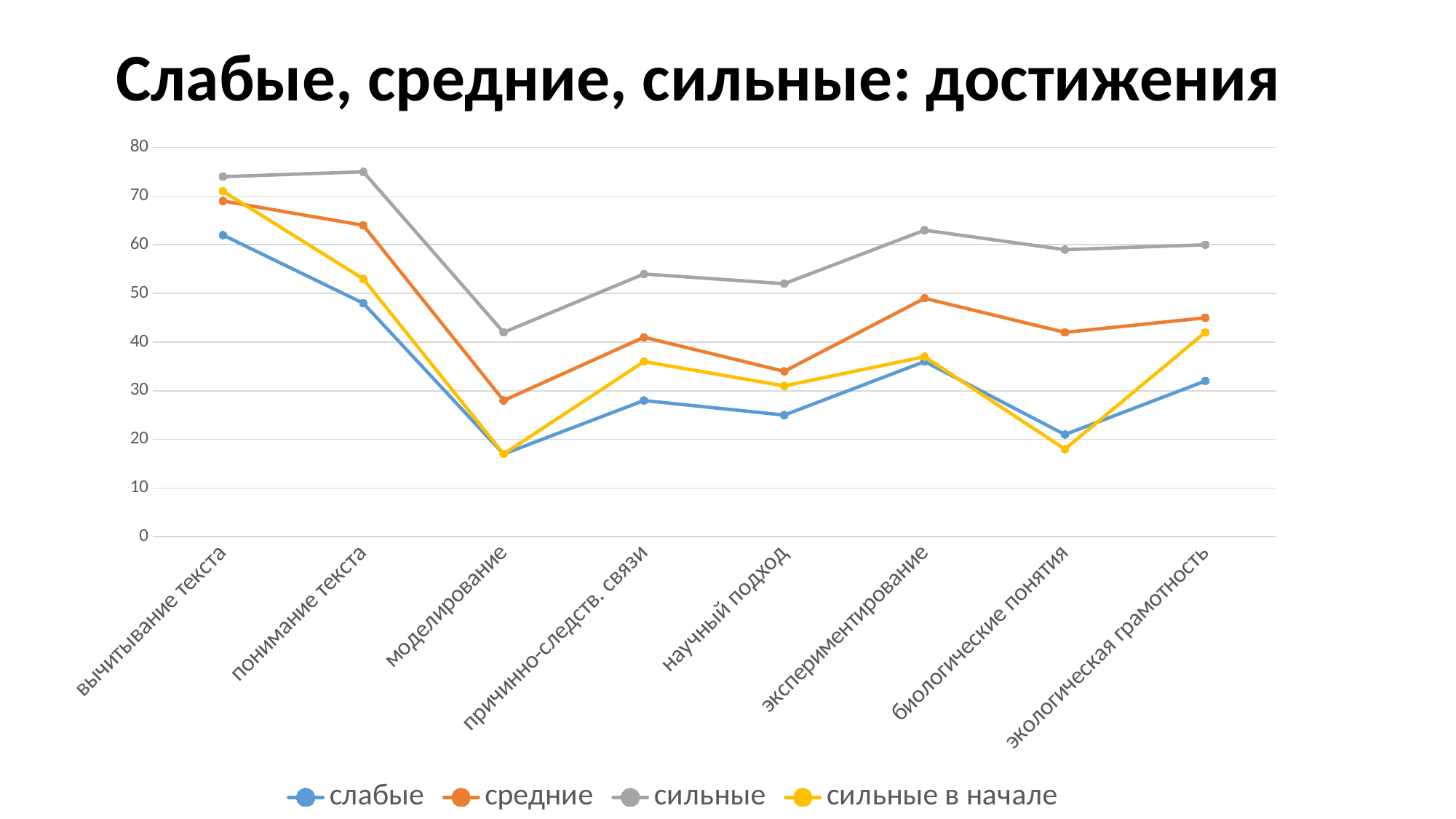
How many categories are plotted along the x axis? 8 What kind of chart is shown on the slide? line chart How many series does the legend list? 4 Is the value for 'слабые' at 'моделирование' greater or less than 20? less Does the 'слабые' series rise or fall from 'вычитывание текста' to 'моделирование'? fall For the series 'слабые', which category has the highest value? вычитывание текста Is the value for 'средние' at 'вычитывание текста' greater or less than 60? greater Is the value for 'сильные' at 'моделирование' greater or less than 50? less At 'экологическая грамотность', which series has the higher value: 'сильные' or 'слабые'? сильные At 'биологические понятия', which series has the higher value: 'средние' or 'сильные в начале'? средние For the series 'сильные', which category has the lowest value? моделирование What is the title of the slide? Слабые, средние, сильные: достижения